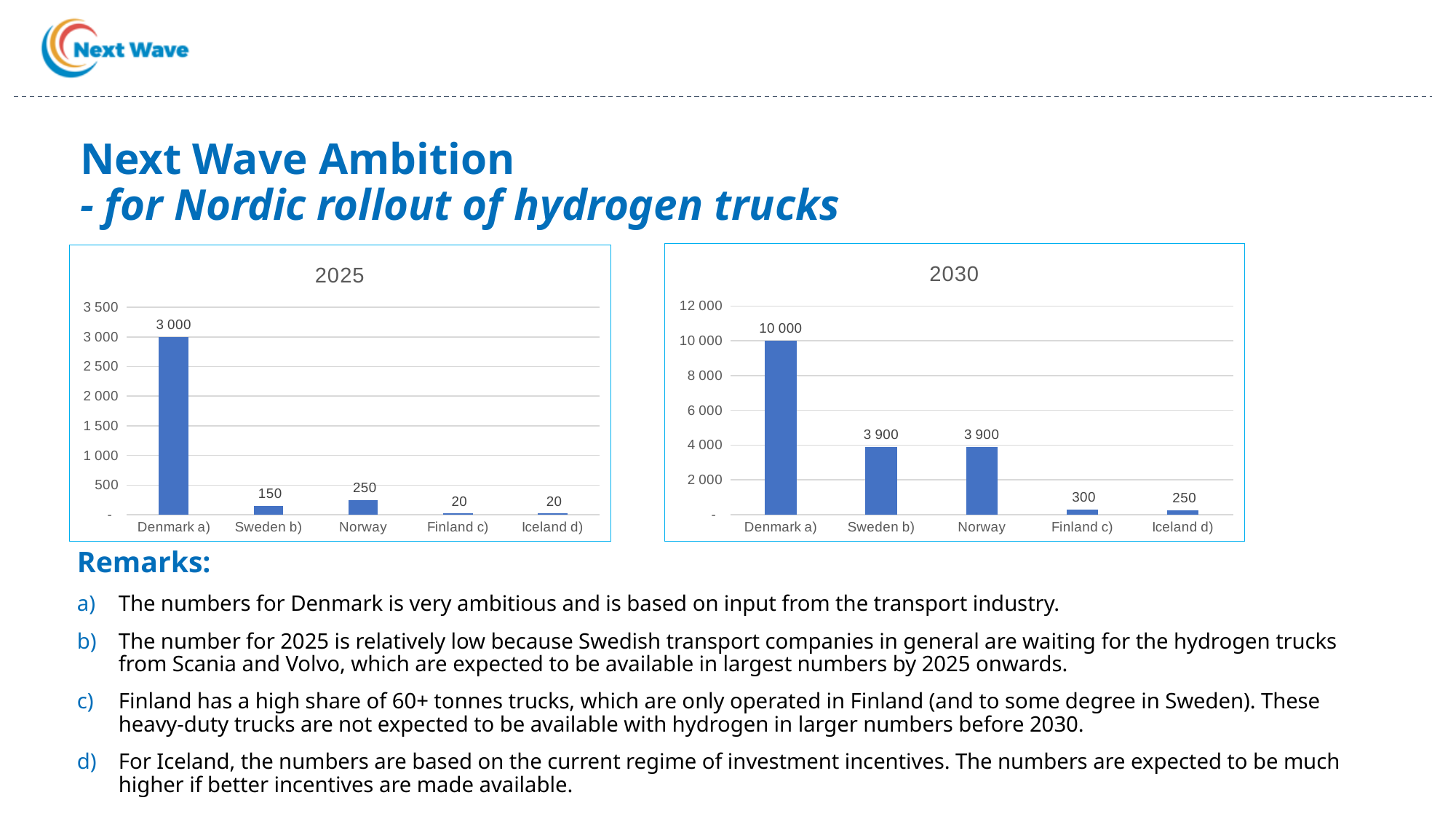
In the 2025 chart, what is the difference between the values for Norway and Sweden b)? 100 In the 2030 chart, is the value for Iceland d) larger or smaller than the value for Finland c)? smaller How many categories are shown in the 2025 chart? 5 What is the title of the chart on the left side of the slide? 2025 In the 2025 chart, which category has the lowest value, Sweden b) or Norway? Sweden b) In the 2025 chart, what is the value for Norway? 250 In the 2030 chart, what is the value for Sweden b)? 3 900 In the 2030 chart, which category has the highest value? Denmark a) What kind of chart is the 2030 chart? bar chart In the 2030 chart, what is the difference between the values for Denmark a) and Norway? 6 100 In the 2025 chart, what is the value for Denmark a)? 3 000 In the 2030 chart, what is the value for Finland c)? 300